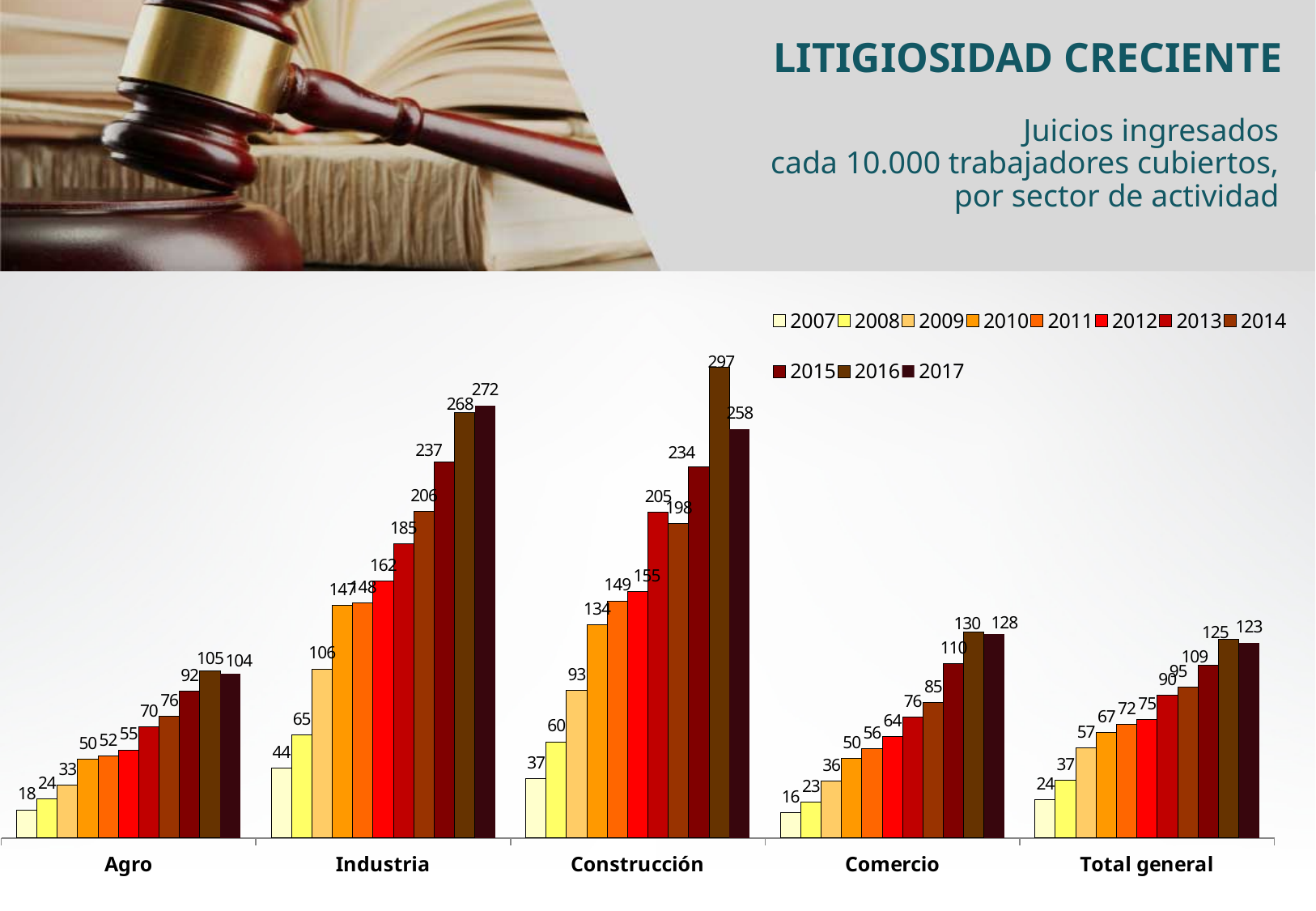
What is the value for Agro in 2007? 18 What is the difference between the Industria values for 2017 and 2007? 228 Which sector has the highest value in 2017? Industria What kind of chart is shown on the slide? Bar chart Which sector has the lowest value in 2007? Comercio Do the values for Industria rise or fall from 2007 to 2017? Rise What is the value for Total general in 2017? 123 Which is larger, the 2016 value for Construcción or the 2016 value for Industria? Construcción How many series does the legend list? 11 What is the value for Construcción in 2016? 297 What is the value for Comercio in 2015? 110 How many sector categories are shown on the x axis? 5